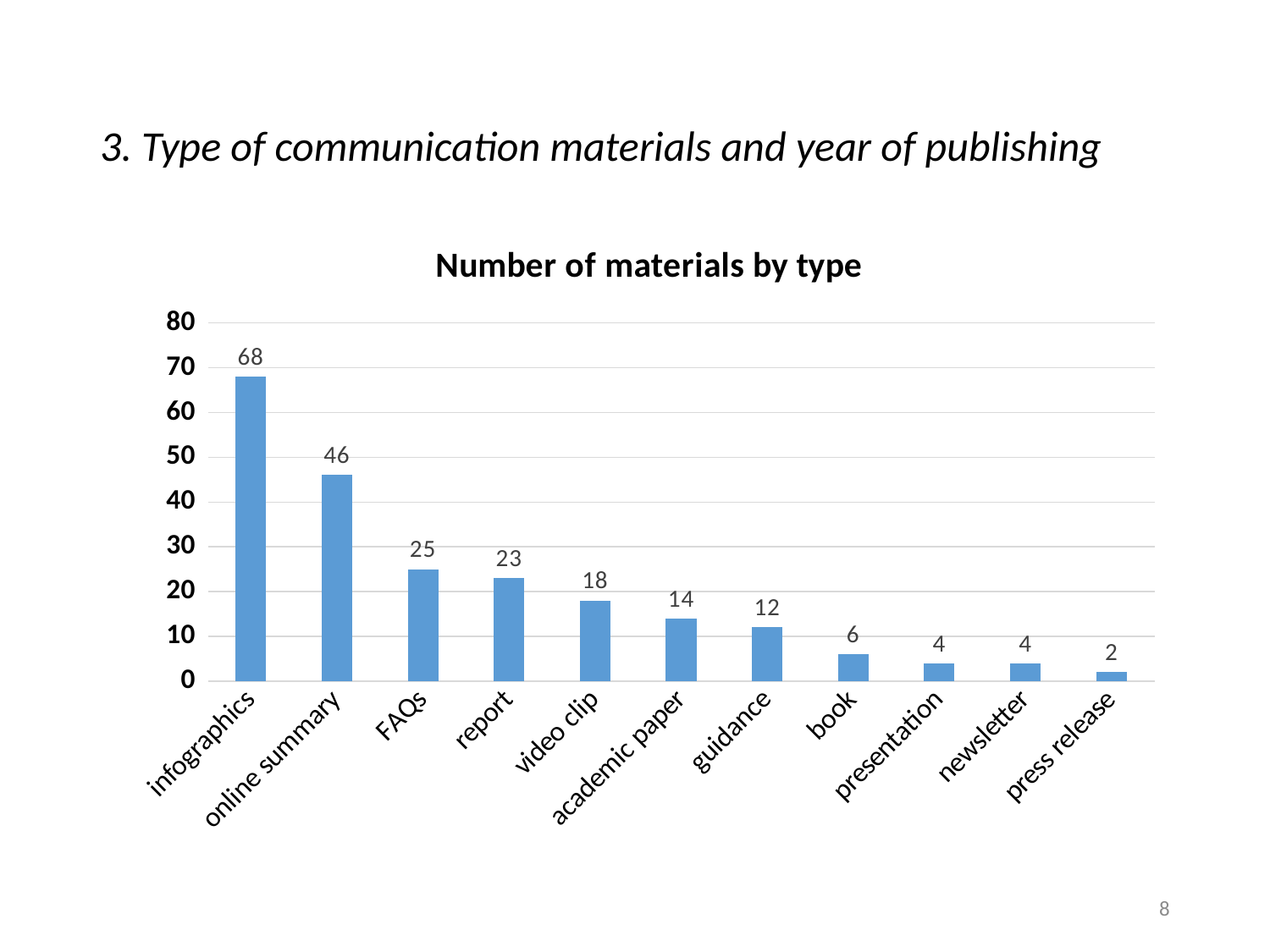
Is the value for online summary greater or less than 40? greater What kind of chart is shown on the slide? bar chart Which has more materials, academic paper or book? academic paper What is the difference between the number of infographics and online summary materials? 22 What is the difference between the number of FAQs and report materials? 2 What is the title of the chart? Number of materials by type What is the number of materials for infographics? 68 Which type of material has the lowest number? press release What is the number of materials for guidance? 12 What is the number of materials for video clip? 18 Which type of material has the highest number? infographics How many types of materials are shown on the chart? 11